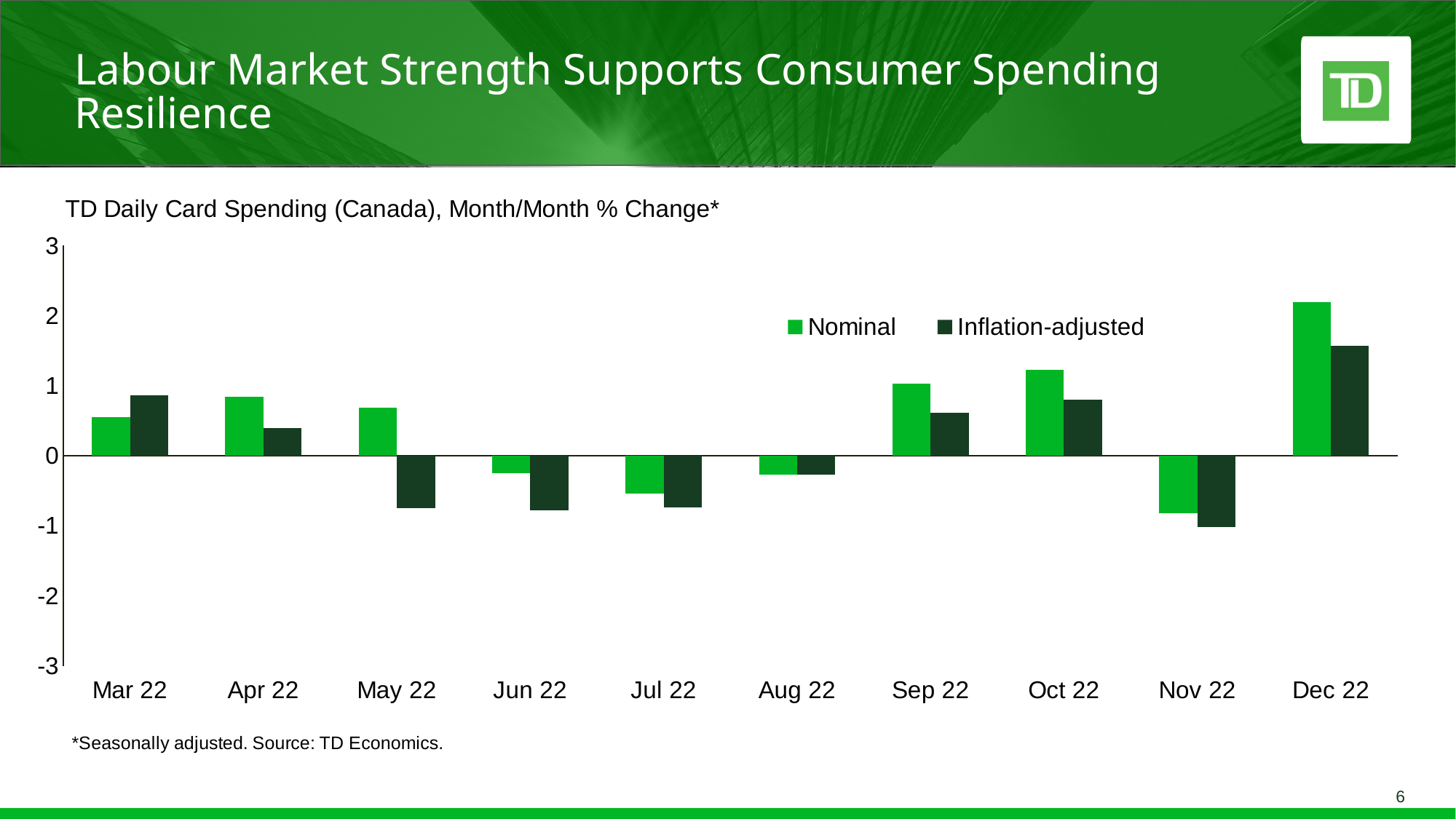
How many months are shown on the x axis? 10 Which month has the highest Nominal value? Dec 22 For Mar 22, which is larger: the Nominal or the Inflation-adjusted value? Inflation-adjusted Is the Nominal value for Dec 22 greater or less than 2? greater How many series does the legend list? 2 Is the Inflation-adjusted value for May 22 greater or less than 0? less For Dec 22, which is larger: the Nominal or the Inflation-adjusted value? Nominal Is the Nominal value for Oct 22 greater or less than 1? greater What is the title of the chart? TD Daily Card Spending (Canada), Month/Month % Change* Which month has the lowest Inflation-adjusted value? Nov 22 What kind of chart is shown on the slide? Bar chart